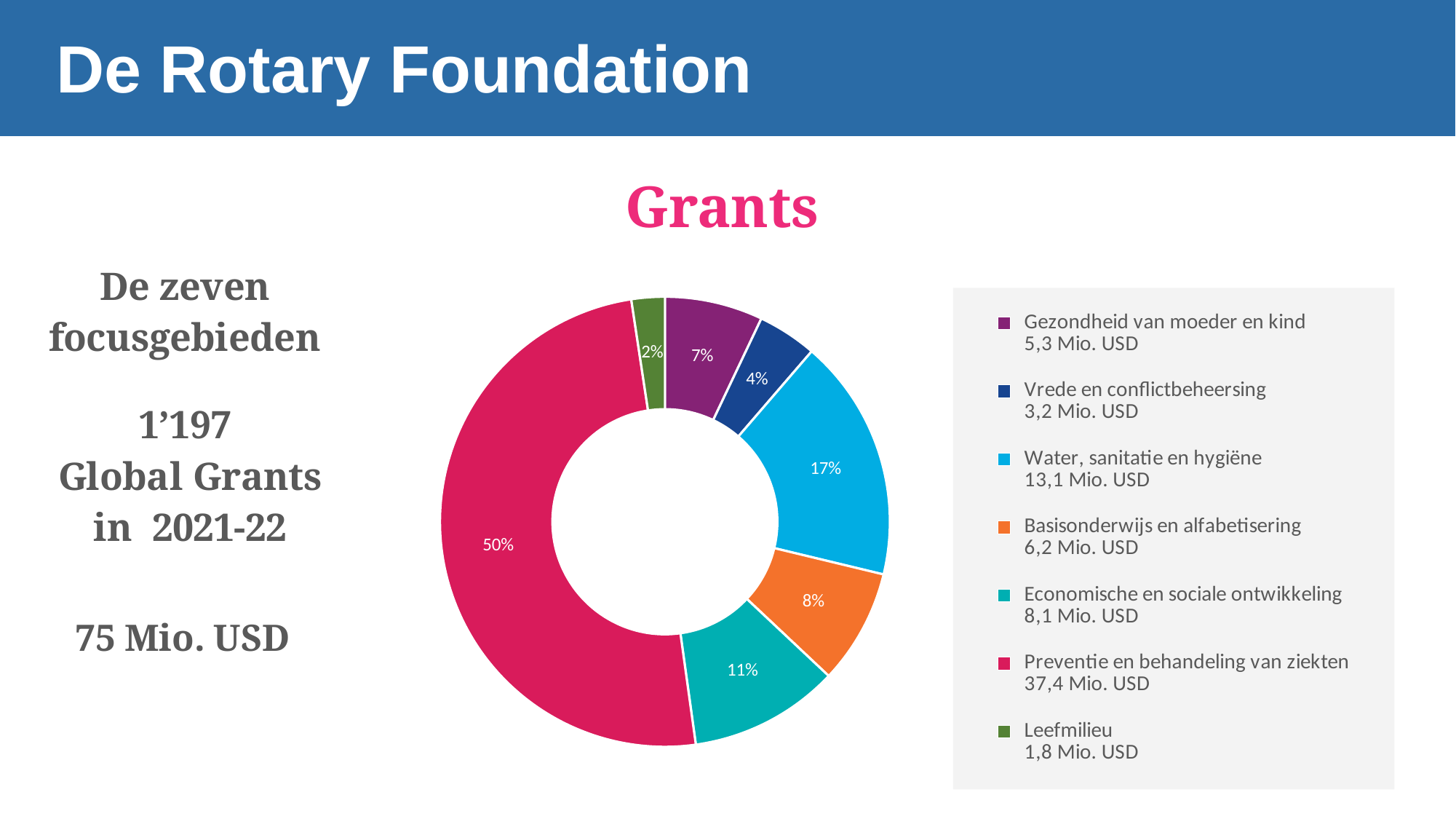
What share of the Grants chart does Water, sanitatie en hygiëne represent? 17% Which is larger in the Grants chart: Basisonderwijs en alfabetisering or Vrede en conflictbeheersing? Basisonderwijs en alfabetisering What amount does the legend give for Water, sanitatie en hygiëne? 13,1 Mio. USD Which category has the largest slice in the Grants chart? Preventie en behandeling van ziekten Which category has the smallest slice in the Grants chart? Leefmilieu What colour is the Preventie en behandeling van ziekten slice in the Grants chart? Pink/magenta What share of the Grants chart does Leefmilieu represent? 2% How many categories does the Grants chart show? 7 What share of the Grants chart does Preventie en behandeling van ziekten represent? 50% What kind of chart is the Grants chart? Pie chart (doughnut) What is the difference in percentage points between the Water, sanitatie en hygiëne slice and the Gezondheid van moeder en kind slice? 10 percentage points